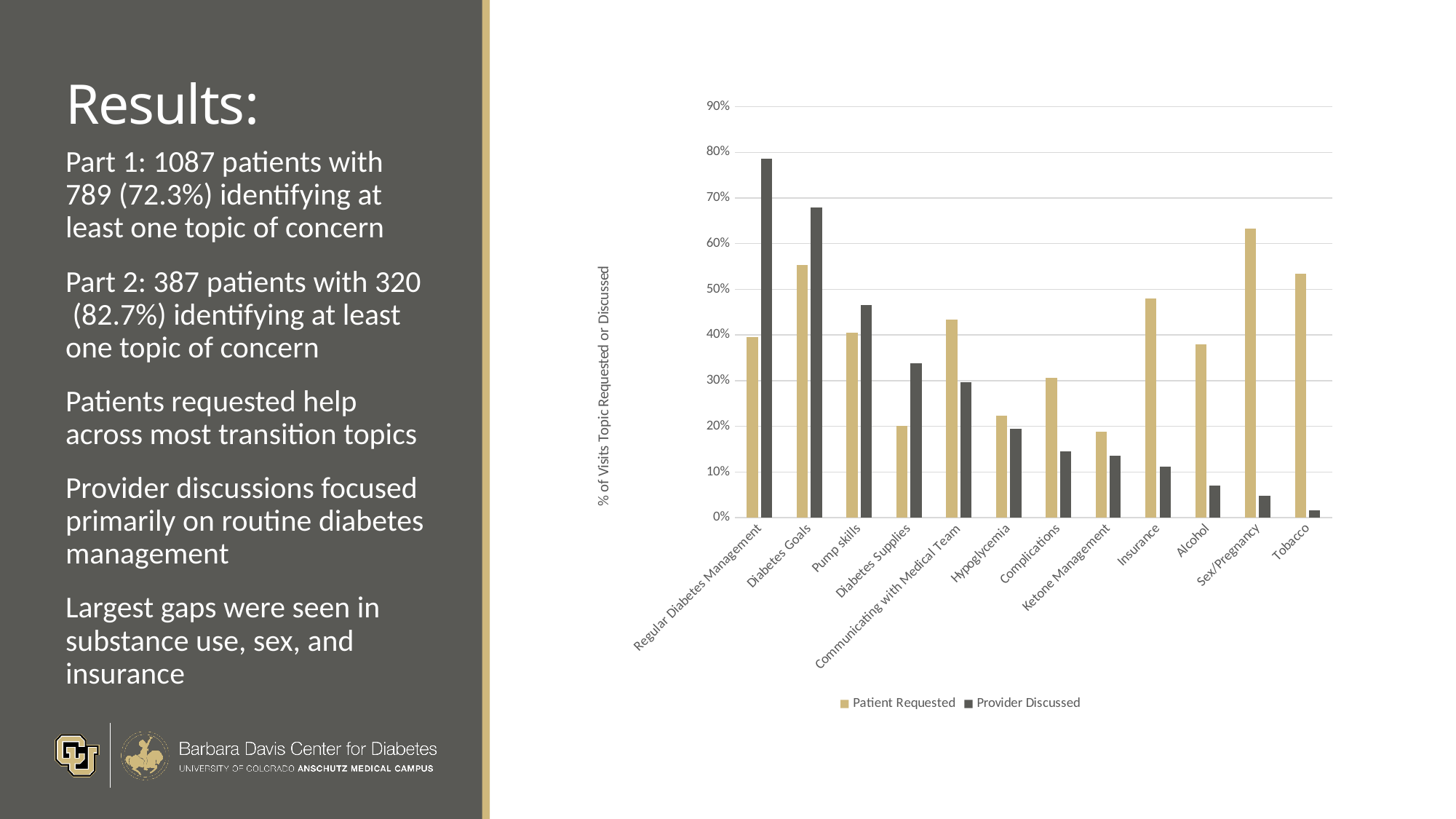
Is the Provider Discussed value for Regular Diabetes Management greater or less than 70%? greater What kind of chart is shown on the slide? Bar chart Which topic has the highest Provider Discussed value? Regular Diabetes Management Is the Patient Requested value for Sex/Pregnancy greater or less than 60%? greater Which topic has the lowest Provider Discussed value? Tobacco For Diabetes Supplies, which is larger: Patient Requested or Provider Discussed? Provider Discussed How many topic categories are shown on the x axis of the chart? 12 How many series does the chart legend list? 2 Is the Provider Discussed value for Alcohol greater or less than 10%? less Which topic has the highest Patient Requested value? Sex/Pregnancy What is the label on the vertical axis of the chart? % of Visits Topic Requested or Discussed For Insurance, which is larger: Patient Requested or Provider Discussed? Patient Requested